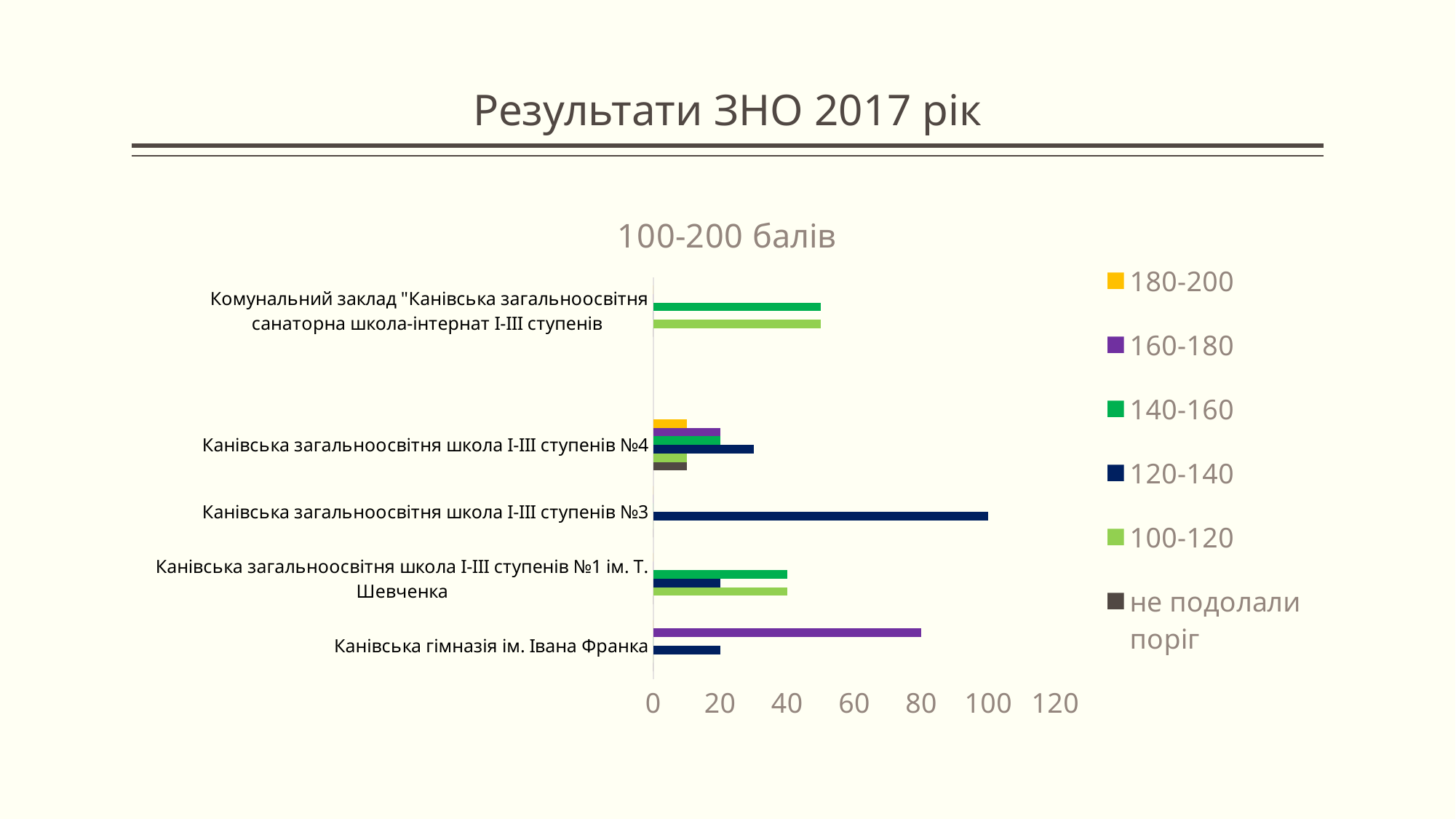
What is the title of the chart? 100-200 балів What kind of chart is shown on the slide? bar chart What is the value of the 160-180 bar for Канівська гімназія ім. Івана Франка? 80 How many schools (categories) are listed on the vertical axis of the chart? 5 Is the 120-140 value for Канівська загальноосвітня школа I-III ступенів №4 greater or less than 40? less What is the value of the 120-140 bar for Канівська загальноосвітня школа I-III ступенів №3? 100 Which school has the larger 140-160 value: Канівська загальноосвітня школа I-III ступенів №1 ім. Т. Шевченка or Канівська загальноосвітня школа I-III ступенів №4? Канівська загальноосвітня школа I-III ступенів №1 ім. Т. Шевченка Is the 160-180 value for Канівська гімназія ім. Івана Франка greater or less than 60? greater For Канівська гімназія ім. Івана Франка, which is larger: the 160-180 bar or the 120-140 bar? 160-180 Is the 140-160 value for Комунальний заклад "Канівська загальноосвітня санаторна школа-інтернат I-III ступенів" greater or less than 40? greater How many series does the chart legend list? 6 Which school has the longest 120-140 bar? Канівська загальноосвітня школа I-III ступенів №3